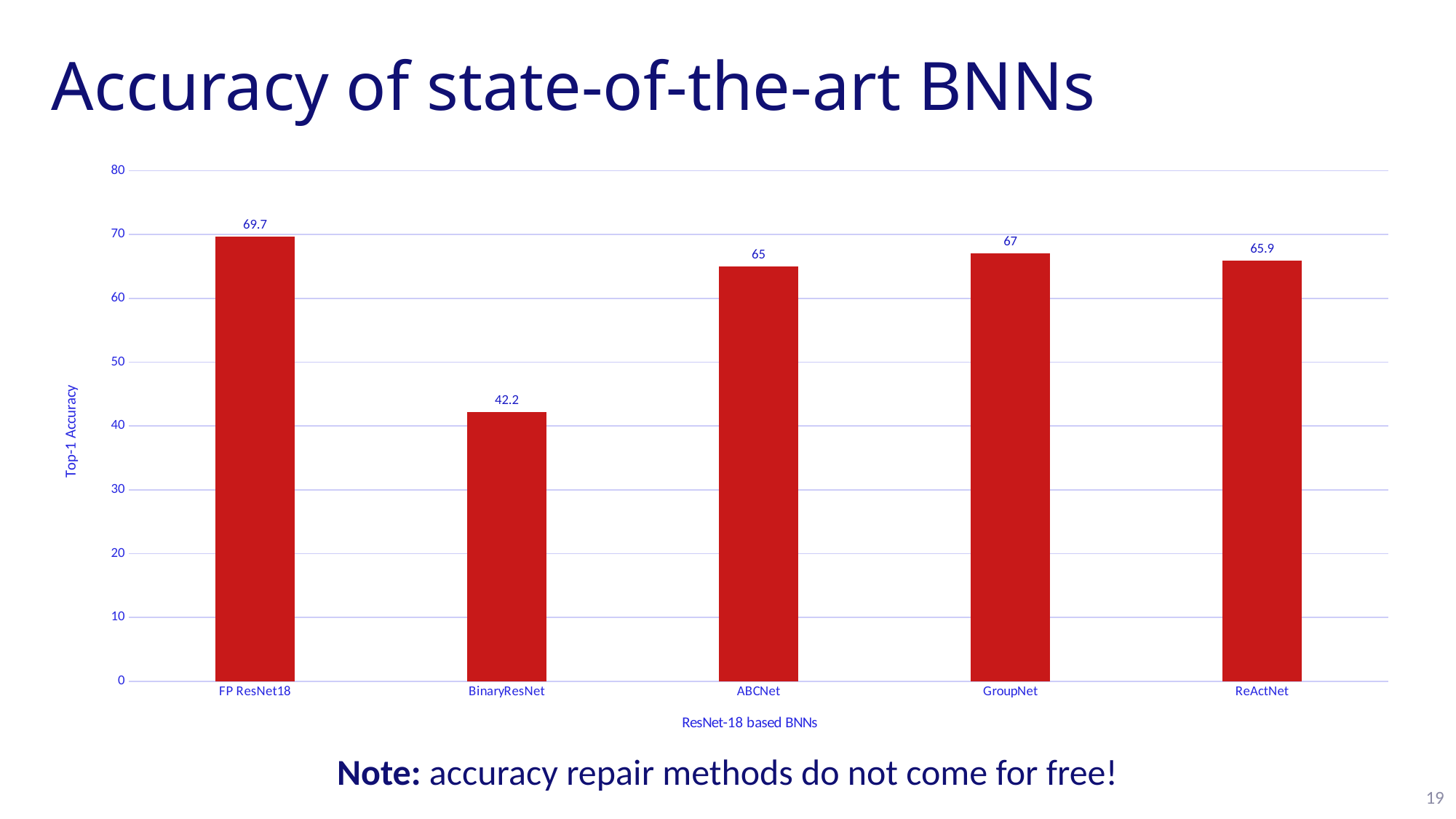
What is the difference in Top-1 Accuracy between GroupNet and ABCNet? 2 Which category has the highest Top-1 Accuracy? FP ResNet18 What is the Top-1 Accuracy for FP ResNet18? 69.7 Which category has the lowest Top-1 Accuracy? BinaryResNet What is the difference in Top-1 Accuracy between FP ResNet18 and BinaryResNet? 27.5 Which has a higher Top-1 Accuracy, ABCNet or BinaryResNet? ABCNet What kind of chart is shown on the slide? Bar chart What is the Top-1 Accuracy for BinaryResNet? 42.2 How many categories are shown on the x axis? 5 What is the Top-1 Accuracy for GroupNet? 67 What is the label of the x axis? ResNet-18 based BNNs What is the Top-1 Accuracy for ReActNet? 65.9